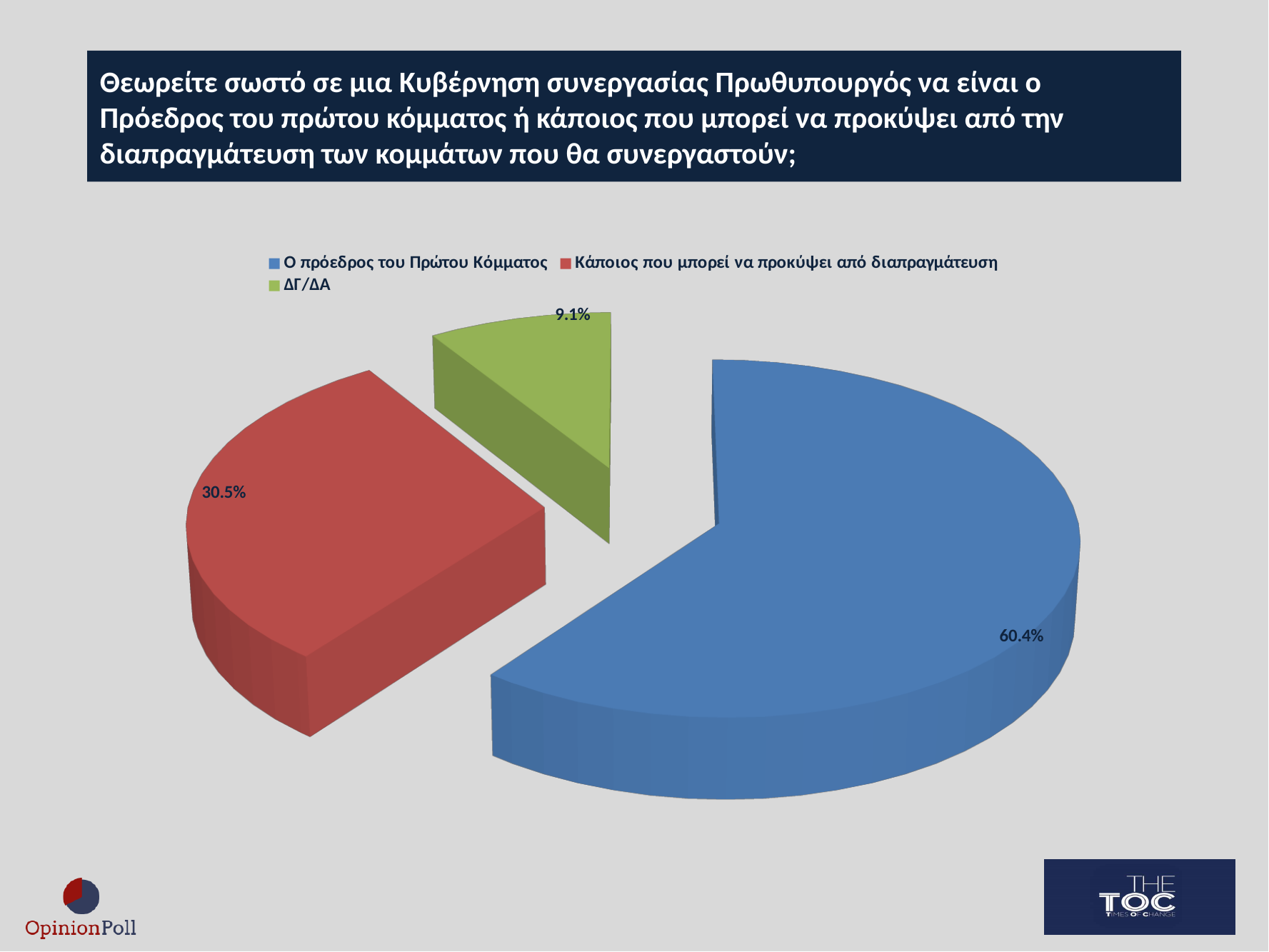
What is the difference in percentage points between 'Κάποιος που μπορεί να προκύψει από διαπραγμάτευση' and 'ΔΓ/ΔΑ'? 21.4 What colour is the slice for 'ΔΓ/ΔΑ'? Green Which is larger: the share for 'Κάποιος που μπορεί να προκύψει από διαπραγμάτευση' or the share for 'ΔΓ/ΔΑ'? Κάποιος που μπορεί να προκύψει από διαπραγμάτευση Which category has the largest share of the pie? Ο πρόεδρος του Πρώτου Κόμματος How many slices does the pie chart have? 3 What percentage is shown for 'Ο πρόεδρος του Πρώτου Κόμματος'? 60.4% What kind of chart is shown on the slide? Pie chart What percentage is shown for 'ΔΓ/ΔΑ'? 9.1% How many entries does the legend list? 3 What percentage is shown for 'Κάποιος που μπορεί να προκύψει από διαπραγμάτευση'? 30.5% What is the difference in percentage points between 'Ο πρόεδρος του Πρώτου Κόμματος' and 'Κάποιος που μπορεί να προκύψει από διαπραγμάτευση'? 29.9 Which category has the smallest share of the pie? ΔΓ/ΔΑ